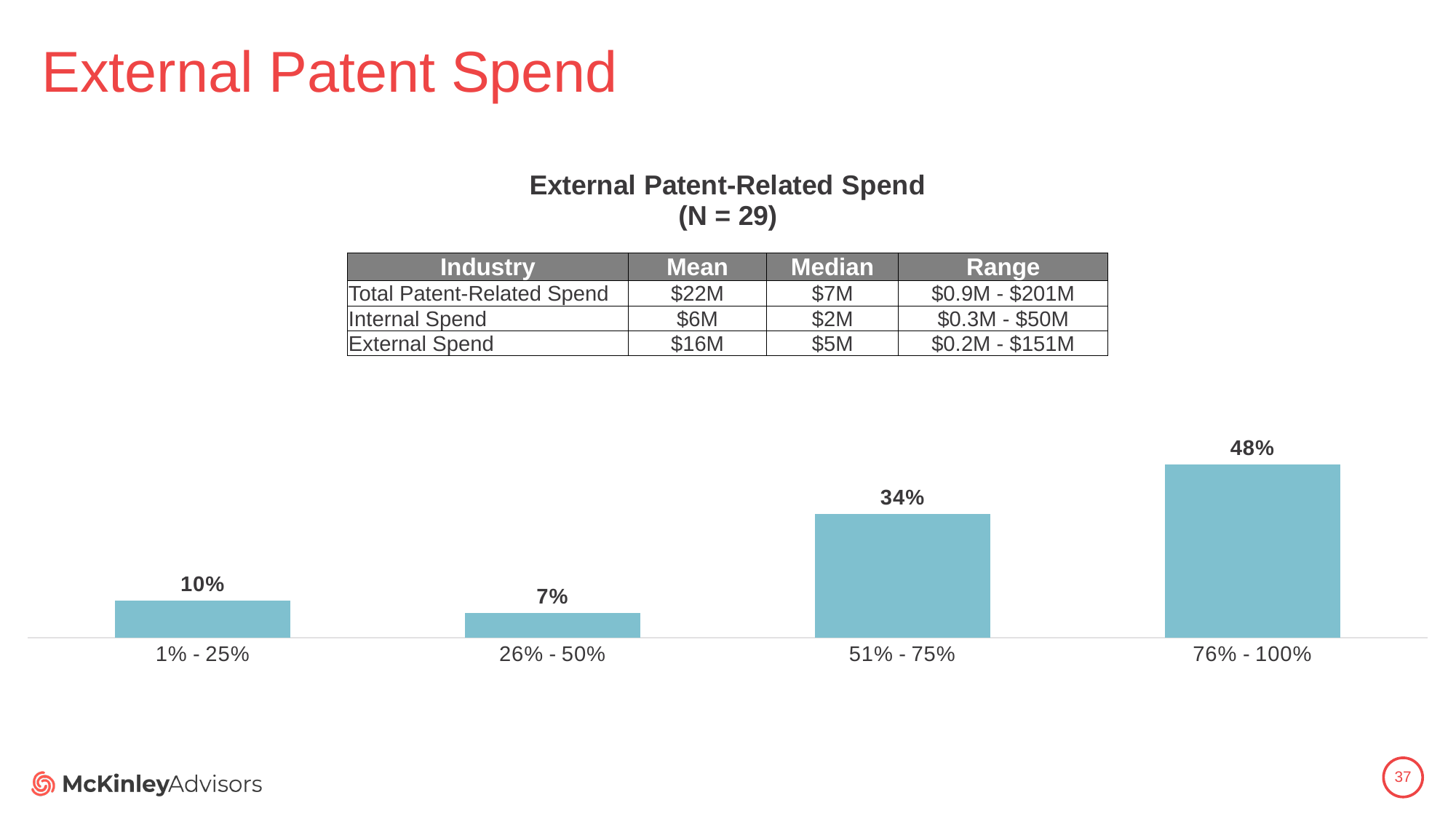
Which category has the highest value? 76% - 100% Which category has the lowest value? 26% - 50% Do the values rise or fall from the 26% - 50% category to the 76% - 100% category? Rise What is the value for the 51% - 75% category? 34% What is the value for the 26% - 50% category? 7% What is the difference between the values for 1% - 25% and 26% - 50%? 3% What is the difference between the values for 76% - 100% and 51% - 75%? 14% What kind of chart is shown on the slide? Bar chart Which is larger, the value for 51% - 75% or the value for 1% - 25%? 51% - 75% What is the value for the 76% - 100% category? 48% What is the value for the 1% - 25% category? 10% How many categories are shown in the bar chart? 4